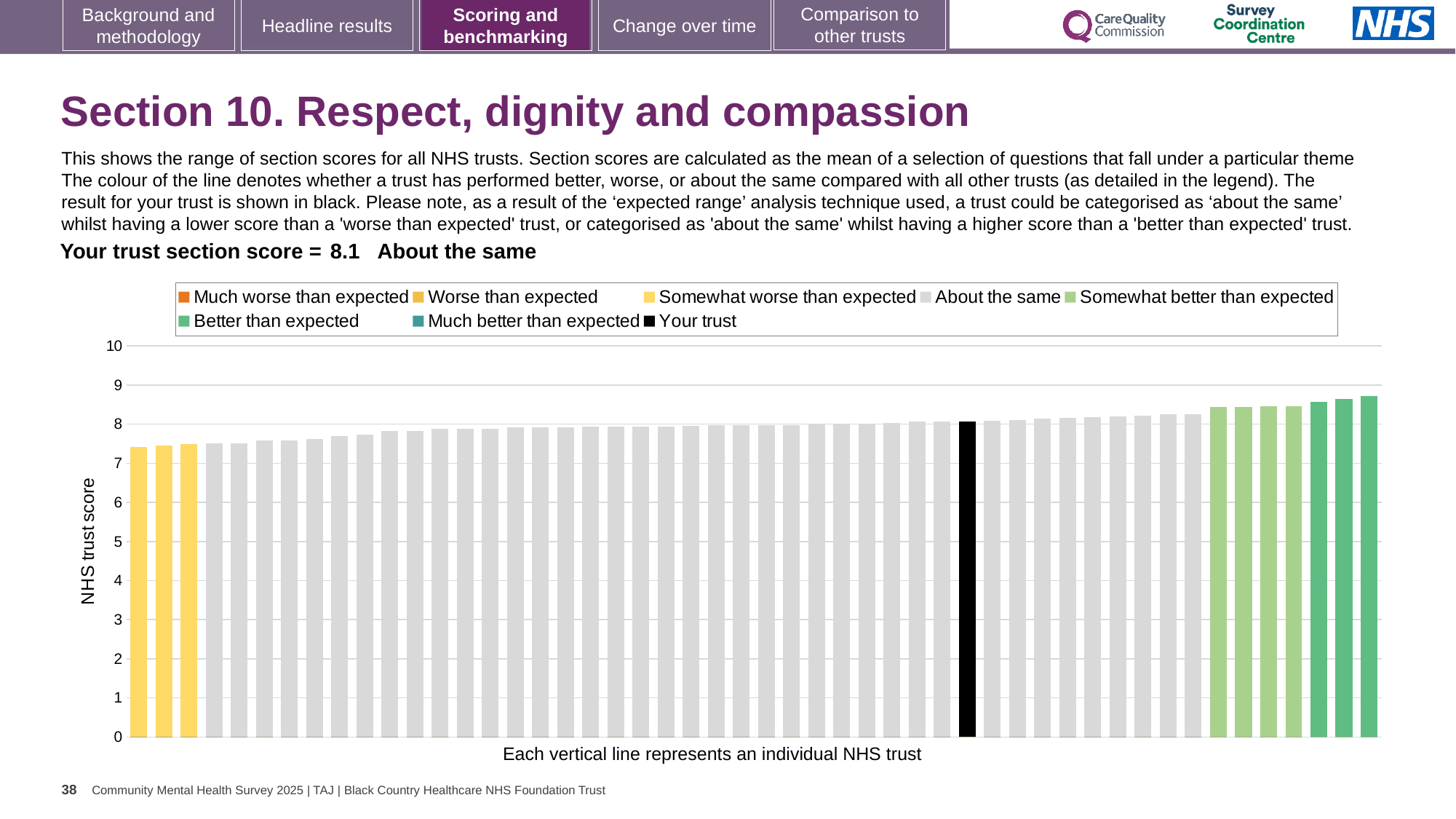
How many bars are coloured dark green (Better than expected) in the chart? 3 What is the label on the vertical axis of the chart? NHS trust score What kind of chart is shown on the slide? bar chart How many entries does the chart legend list? 8 Is the value of the rightmost bar greater or less than 9? less Do the bar values rise or fall from left to right along the x axis? rise Is the value of the leftmost bar greater or less than 8? less What is the section score for your trust shown on the slide? 8.1 Which is larger, the leftmost bar or the rightmost bar? the rightmost bar What colour is the bar representing your trust in the chart? black